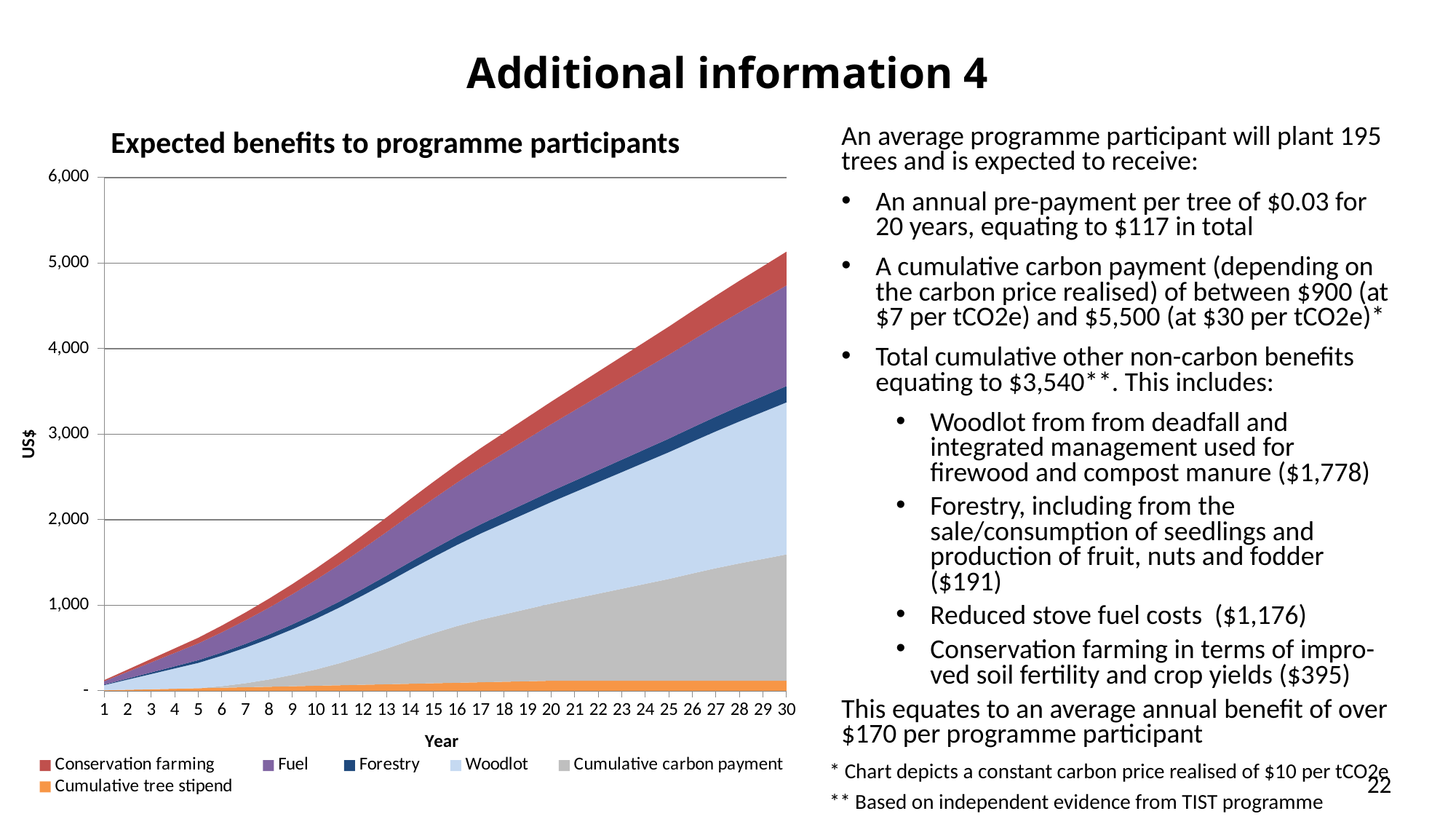
In which year is the total stacked value lowest? 1 How many series does the chart legend list? 6 Is the total stacked value in year 10 greater or less than 2,000? less Is the total stacked value in year 30 greater or less than 4,000? greater In which year is the total stacked value highest? 30 What kind of chart is shown on the slide? Stacked area chart What is the label on the y axis of the chart? US$ What is the title of the chart? Expected benefits to programme participants Do the total expected benefits rise or fall as the year increases? Rise Is the total stacked value in year 5 greater or less than 1,000? less How many years are plotted along the x axis of the chart? 30